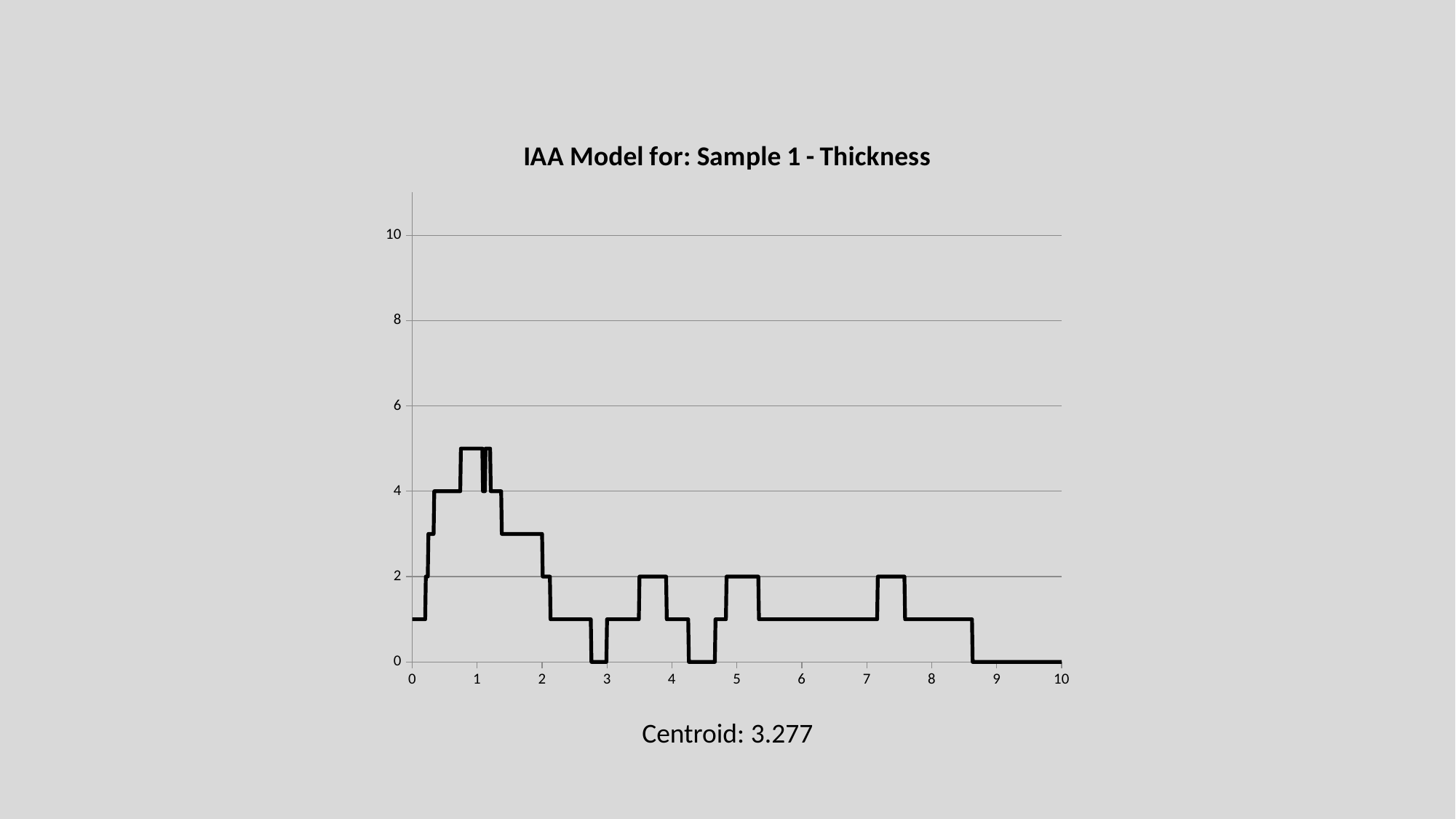
What kind of chart is shown on the slide? line chart From x = 2 to x = 10, does the line generally rise or fall? fall What is the highest value labelled on the y axis? 10 Is the value of the line at x = 0 greater or less than 2? less What is the value of the line at x = 9? 0 Is the highest value reached by the line greater or less than 4? greater Is the value of the line at x = 6 greater or less than 2? less Which is larger, the value of the line at x = 1 or at x = 5? x = 1 What is the value of the line at x = 10? 0 What is the title of the chart? IAA Model for: Sample 1 - Thickness What centroid value is printed below the chart? 3.277